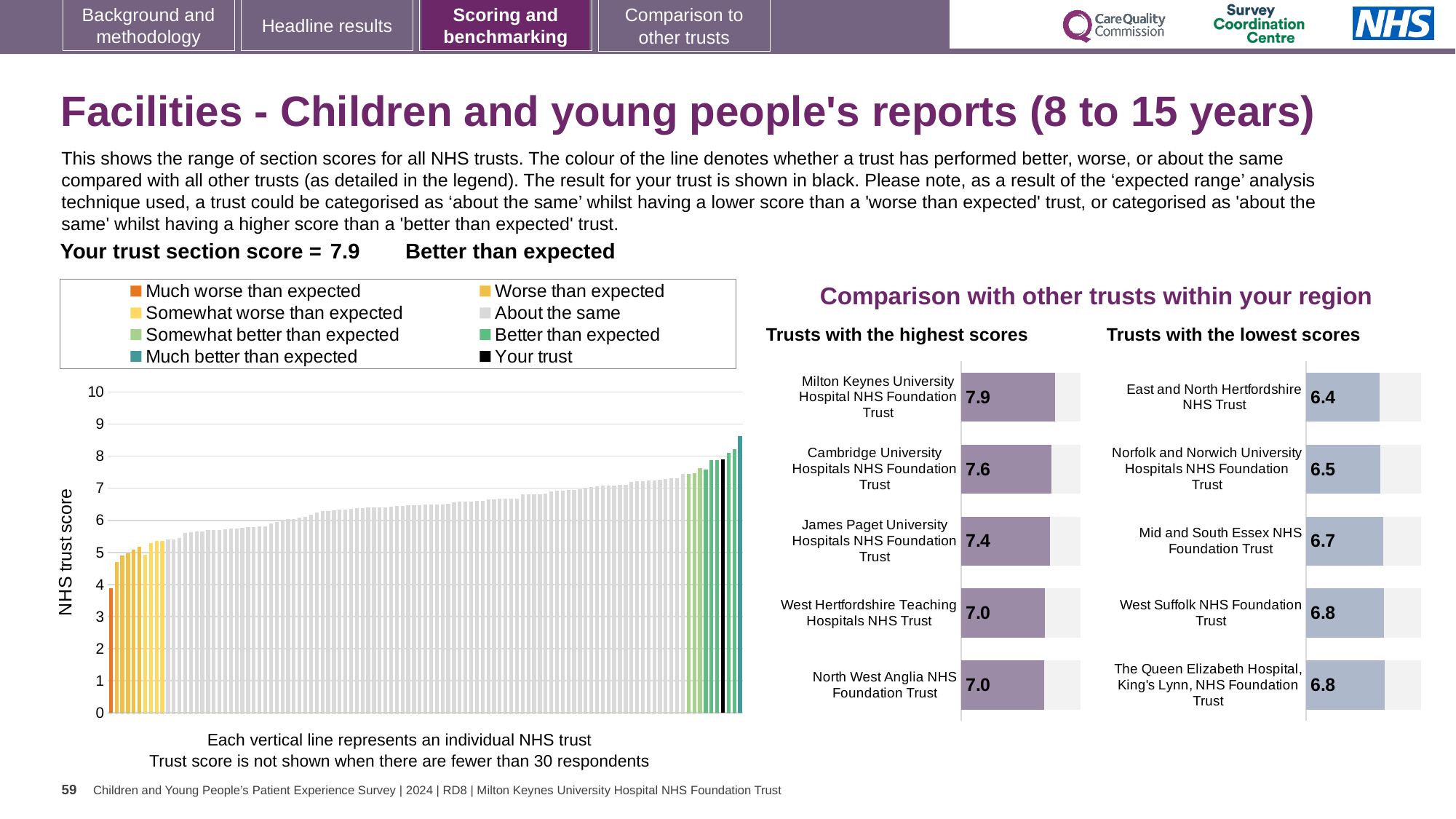
In the 'Trusts with the lowest scores' chart, what is the difference between the scores of West Suffolk NHS Foundation Trust and East and North Hertfordshire NHS Trust? 0.4 In the 'Trusts with the lowest scores' chart, what is the score for Norfolk and Norwich University Hospitals NHS Foundation Trust? 6.5 In the 'Trusts with the highest scores' chart, what is the score for Cambridge University Hospitals NHS Foundation Trust? 7.6 In the 'Trusts with the highest scores' chart, what is the score for James Paget University Hospitals NHS Foundation Trust? 7.4 In the 'Trusts with the highest scores' chart, how many trusts are shown? 5 In the 'Trusts with the lowest scores' chart, which trust has the lowest score? East and North Hertfordshire NHS Trust In the large chart on the left, do the bar values rise or fall from left to right? rise What kind of chart is the large chart on the left with the y-axis labelled 'NHS trust score'? bar chart In the 'Trusts with the highest scores' chart, what is the difference between the scores of Milton Keynes University Hospital NHS Foundation Trust and West Hertfordshire Teaching Hospitals NHS Trust? 0.9 In the large chart on the left, is the value of the lowest (leftmost) bar greater or less than 5? less In the 'Trusts with the lowest scores' chart, what is the score for Mid and South Essex NHS Foundation Trust? 6.7 In the 'Trusts with the highest scores' chart, which trust has the highest score? Milton Keynes University Hospital NHS Foundation Trust